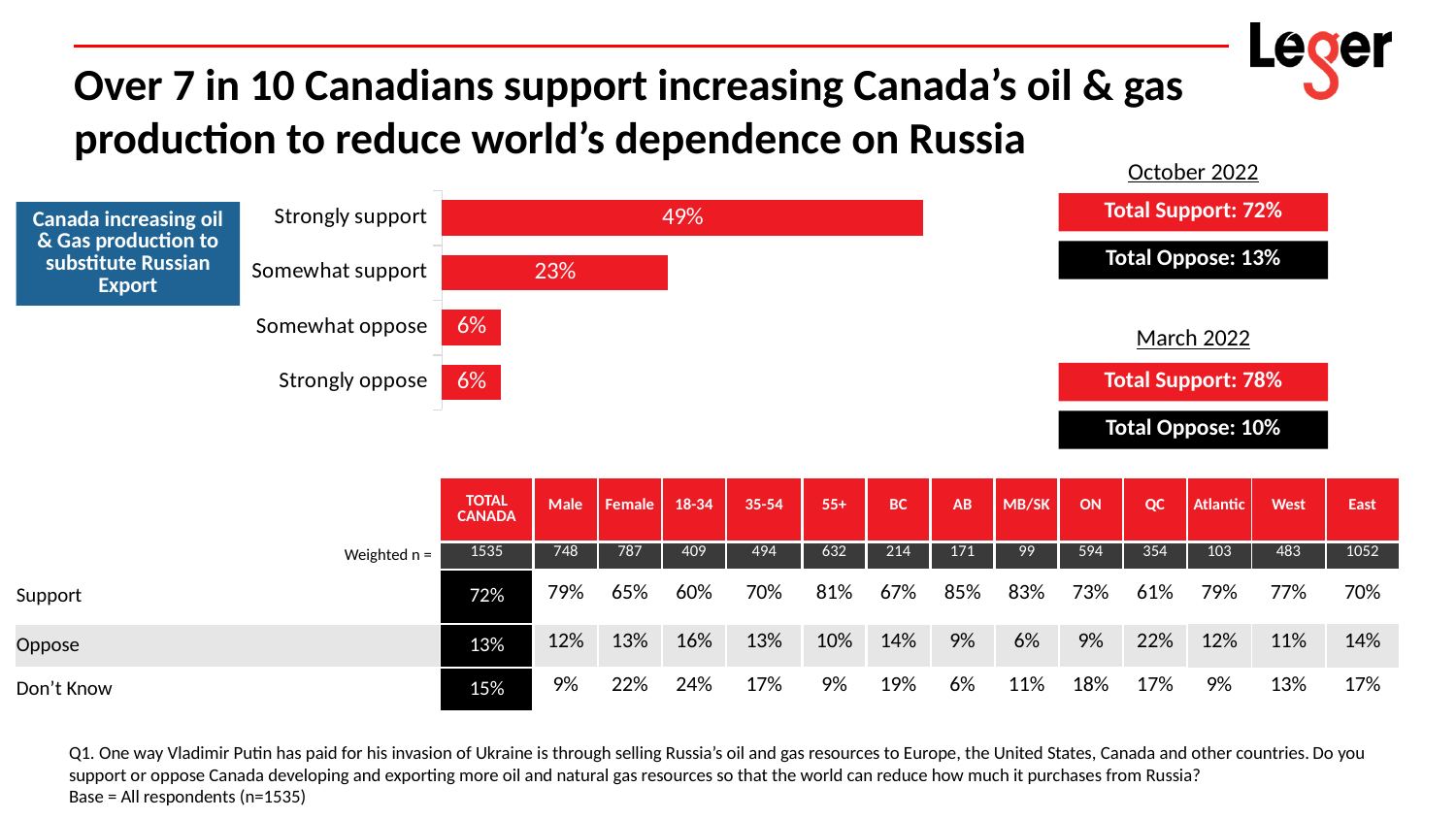
How many response categories are shown in the bar chart? 4 What percentage of respondents somewhat support Canada increasing oil & gas production? 23% What percentage of respondents somewhat oppose Canada increasing oil & gas production? 6% What type of chart is used to show the support and oppose responses? Bar chart What colour are the bars in the chart? Red What percentage of respondents strongly support Canada increasing oil & gas production to substitute Russian export? 49% Which response category has the highest value in the bar chart? Strongly support What is the difference between the Somewhat support and Somewhat oppose values? 17% What is the combined value of the Strongly support and Somewhat support bars? 72% What is the difference between the Strongly support and Somewhat support values? 26% Which is larger, the value for Strongly support or the value for Somewhat support? Strongly support What percentage of respondents strongly oppose Canada increasing oil & gas production? 6%